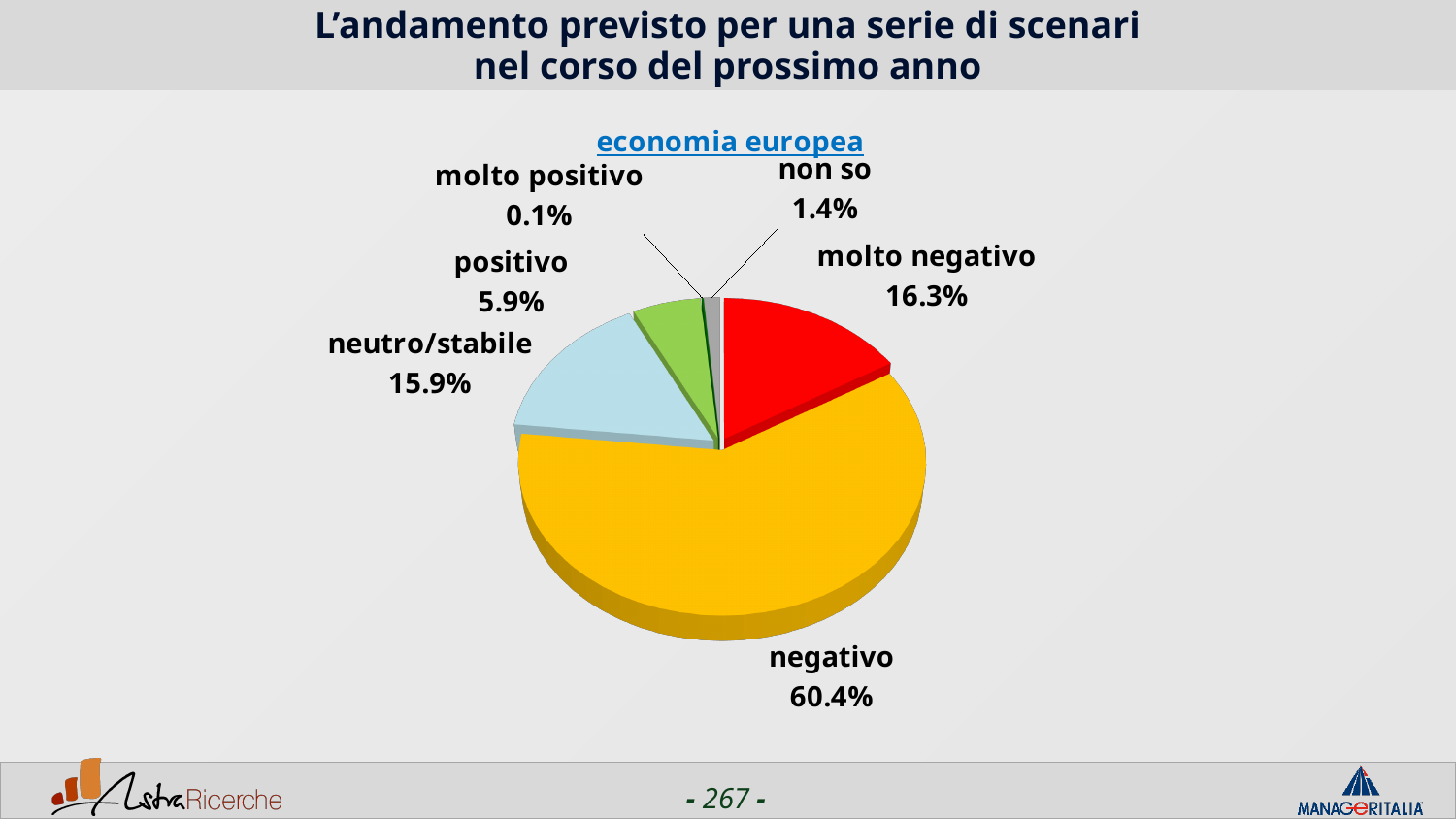
What is the combined share of 'positivo' and 'molto positivo'? 6.0% What type of chart is shown on the slide? Pie chart What percentage of respondents expect the European economy to be 'negativo'? 60.4% Which is larger, 'positivo' or 'neutro/stabile'? neutro/stabile What percentage is labelled 'non so'? 1.4% What is the difference between the 'negativo' and 'molto negativo' shares? 44.1 percentage points What is the share for 'molto negativo' in the pie chart? 16.3% Which category has the smallest slice of the pie? molto positivo How many categories are shown in the pie chart? 6 What value is shown for 'neutro/stabile'? 15.9% What is the subtitle of the pie chart, shown above it in blue? economia europea Which category has the largest slice of the pie? negativo